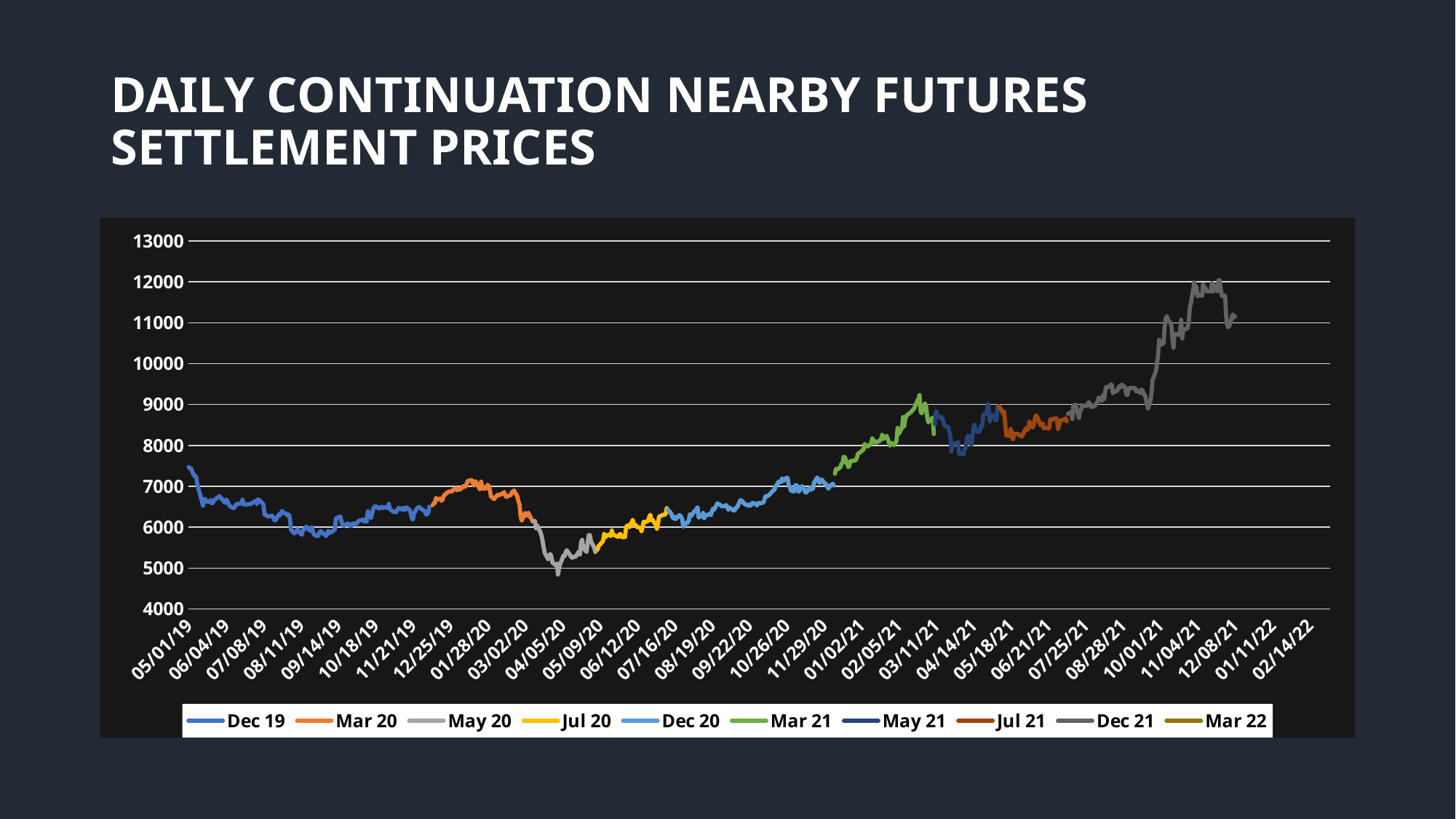
Is the peak value of the Dec 21 series greater or less than 11000? greater Is the peak value of the Mar 21 series greater or less than 8000? greater Which series reaches higher values, Dec 21 or Dec 19? Dec 21 Which series reaches the highest value on the chart? Dec 21 What colour is the Mar 21 series in the legend? Green Is the lowest value of the May 20 series greater or less than 6000? less What is the title of the chart? DAILY CONTINUATION NEARBY FUTURES SETTLEMENT PRICES What kind of chart is shown on the slide? Line chart Overall, do the plotted prices rise or fall from the left of the x axis to the right? rise Which series reaches the lowest value on the chart? May 20 How many series does the legend list? 10